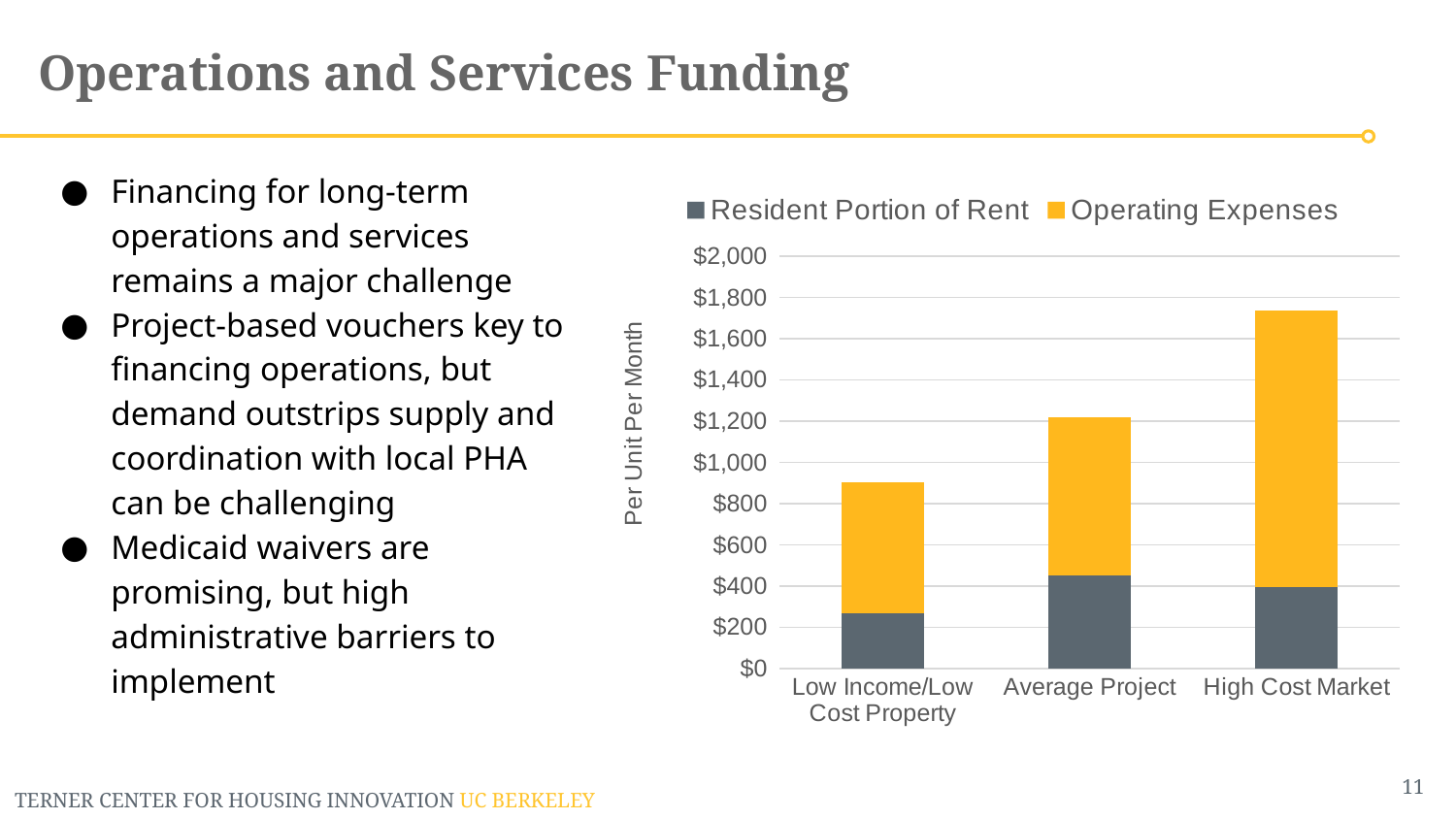
Do the total bar heights rise or fall from left to right across the categories? Rise Is the total bar height for Average Project greater or less than $1,000? greater How many series does the chart's legend list? 2 How many categories are shown on the x axis of the chart? 3 Which category has the tallest stacked bar in the chart? High Cost Market Is the total bar height for Low Income/Low Cost Property greater or less than $1,000? less Is the Resident Portion of Rent for Low Income/Low Cost Property greater or less than $400? less Which has a larger Resident Portion of Rent: Average Project or Low Income/Low Cost Property? Average Project What kind of chart is shown on the slide? Stacked bar chart Which category has the shortest stacked bar in the chart? Low Income/Low Cost Property